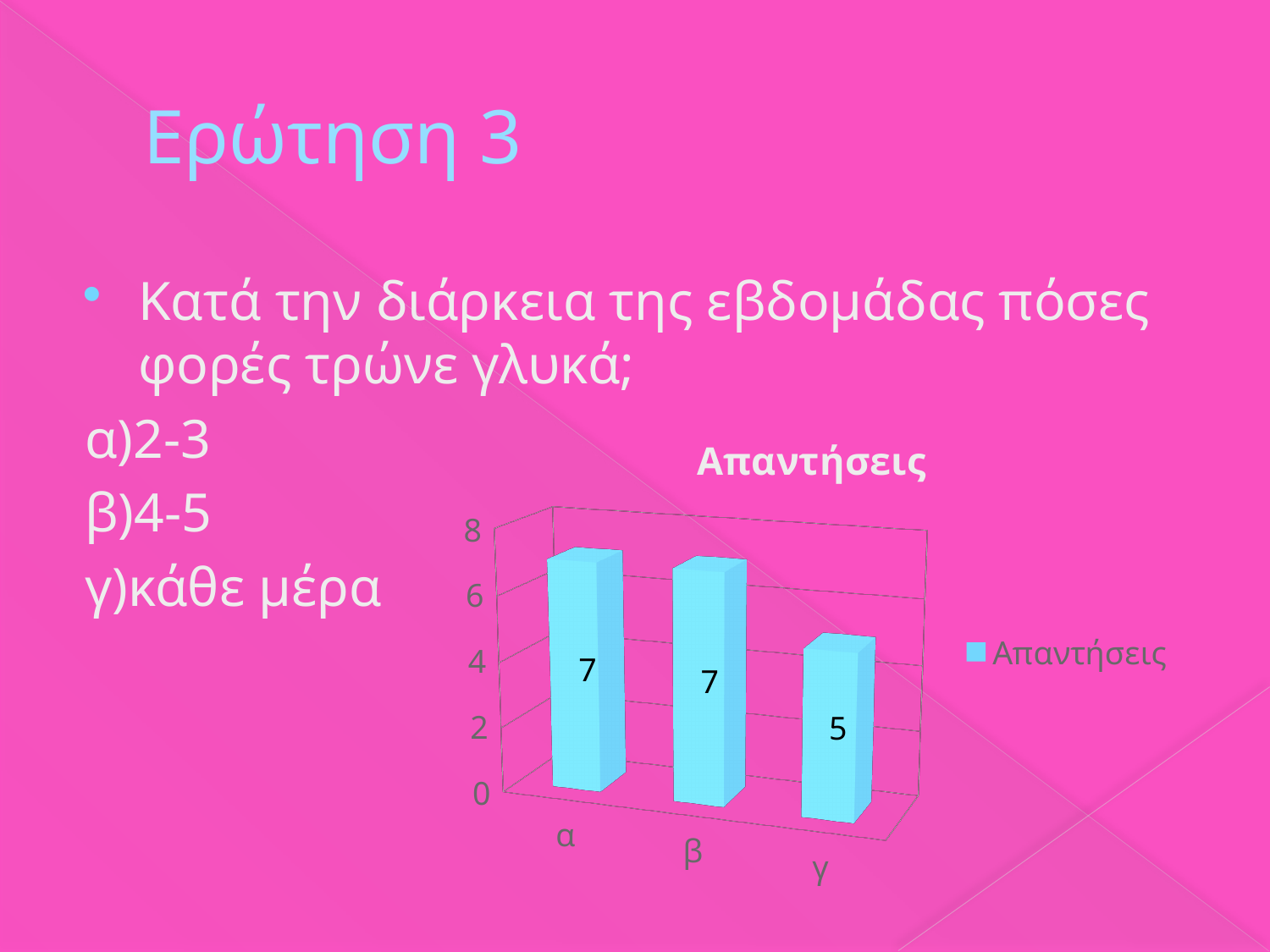
What is the value for category γ? 5 What is the value for category α? 7 How many series does the legend list? 1 What is the difference between the values for α and γ? 2 How many categories are shown on the x axis? 3 What kind of chart is shown? bar chart What is the value for category β? 7 Is the value for α greater or less than 6? greater Which category has the lowest value? γ Which is larger, the value for β or the value for γ? β Is the value for γ greater or less than 6? less What is the title of the chart? Απαντήσεις